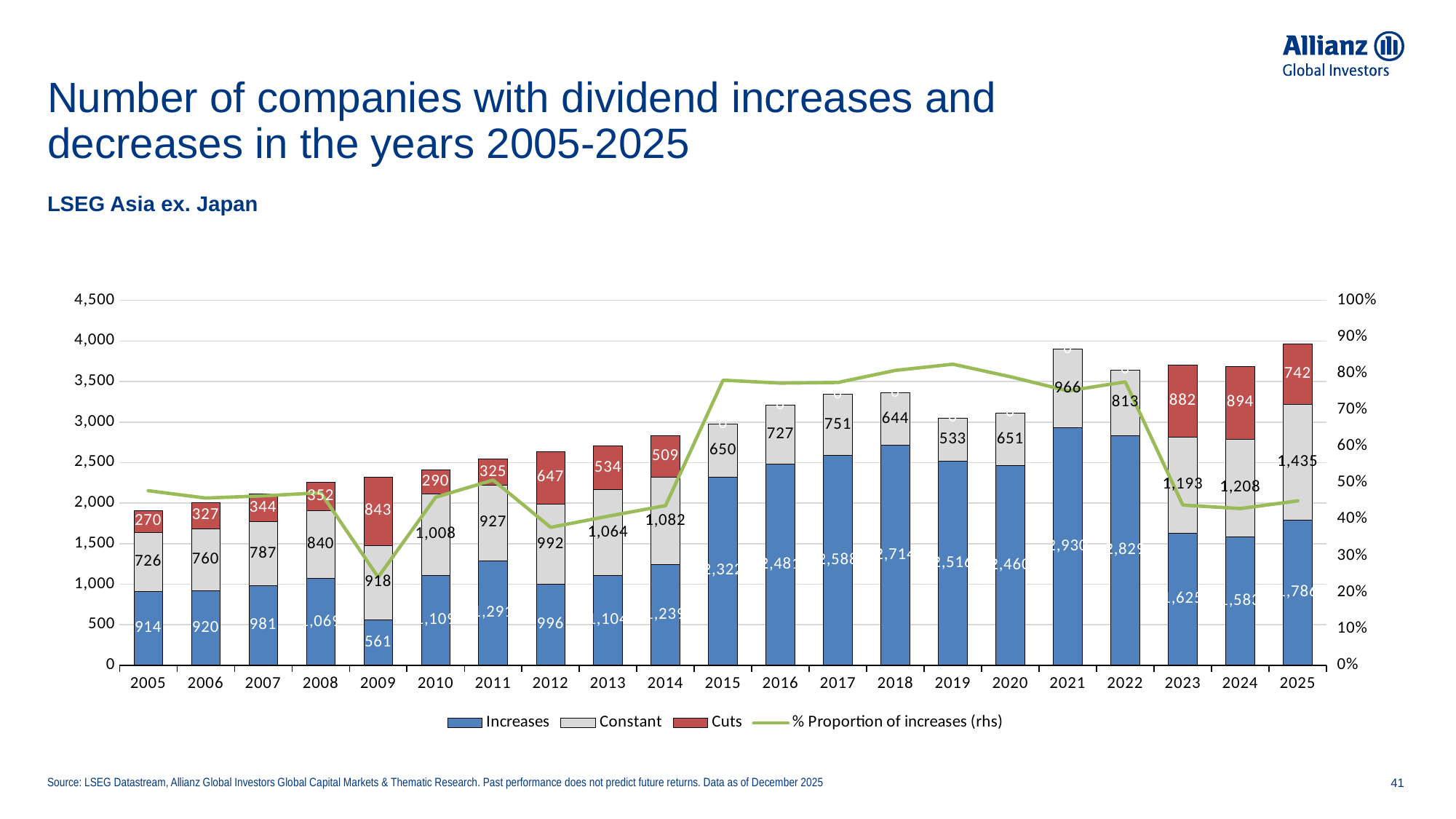
What is the difference between the Cuts value in 2009 and in 2005? 573 In which year is the Increases value lowest? 2009 In which year is the Constant value highest? 2025 What is the value for Constant in 2009? 918 Which is larger, the Cuts value in 2023 or in 2024? 2024 What kind of chart is shown on the slide? Stacked bar chart with a line What is the value for Cuts in 2012? 647 Is the % Proportion of increases in 2009 greater or less than 30%? less How many years are shown on the x axis? 21 What is the value for Constant in 2025? 1,435 How many series does the legend list? 4 What is the value for Increases in 2021? 2,930